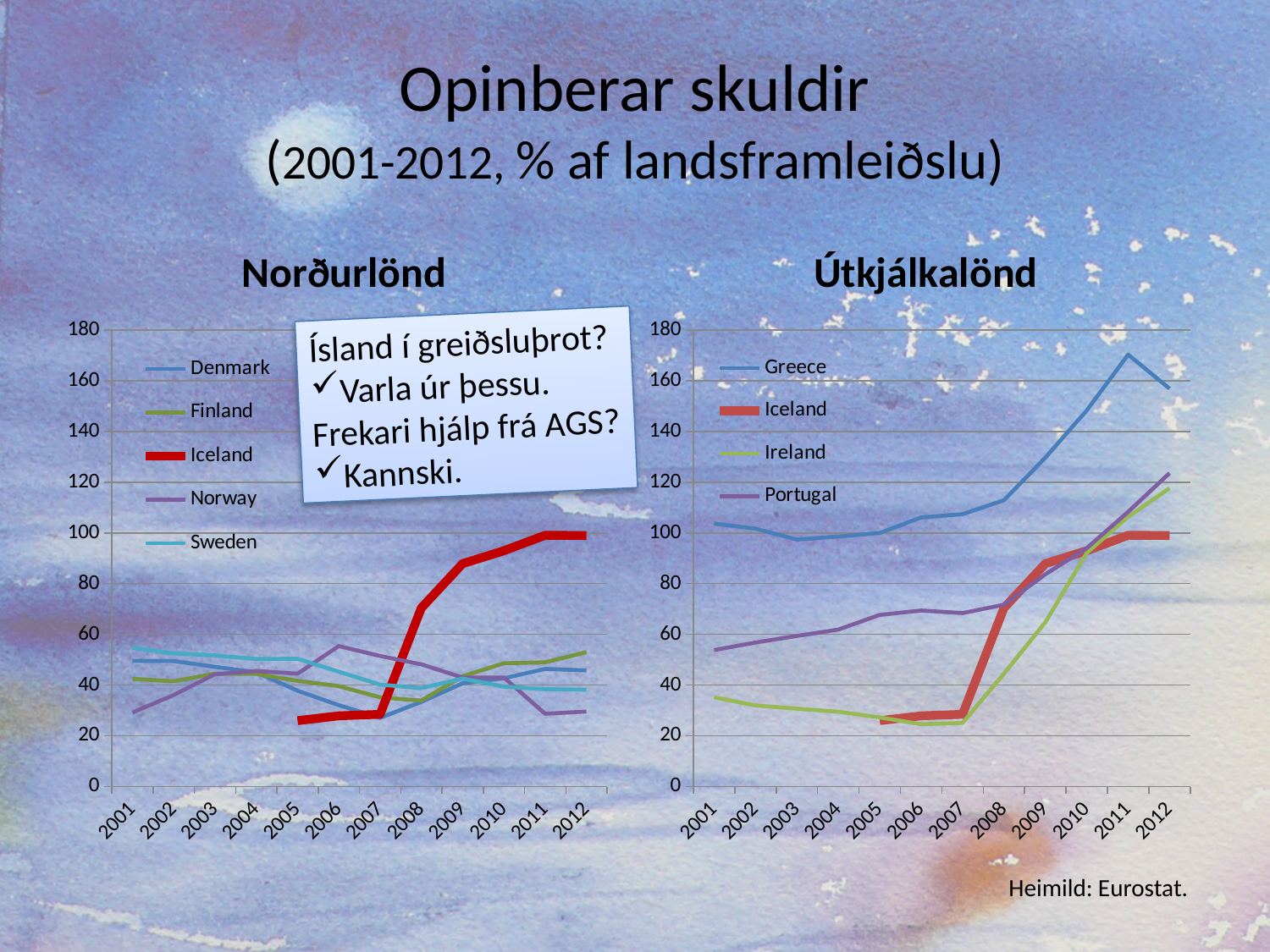
In the Norðurlönd chart, is the value for Iceland in 2005 greater or less than 40? less How many series does the legend of the Norðurlönd chart list? 5 In the Útkjálkalönd chart, is the value for Greece in 2011 greater or less than 160? greater In the Norðurlönd chart, which country has the lowest value in 2012? Norway In the Útkjálkalönd chart, which is larger in 2008, Greece or Portugal? Greece How many series does the legend of the Útkjálkalönd chart list? 4 What kind of chart is the Norðurlönd chart on the left? line chart In the Norðurlönd chart, which country is drawn with the thick red line? Iceland How many years are shown on the x axis of the Útkjálkalönd chart? 12 In the Útkjálkalönd chart, does the Greece line rise or fall from 2001 to 2011? rise In the Útkjálkalönd chart, which country has the highest value in 2012? Greece In the Norðurlönd chart, is the value for Iceland in 2009 greater or less than 80? greater